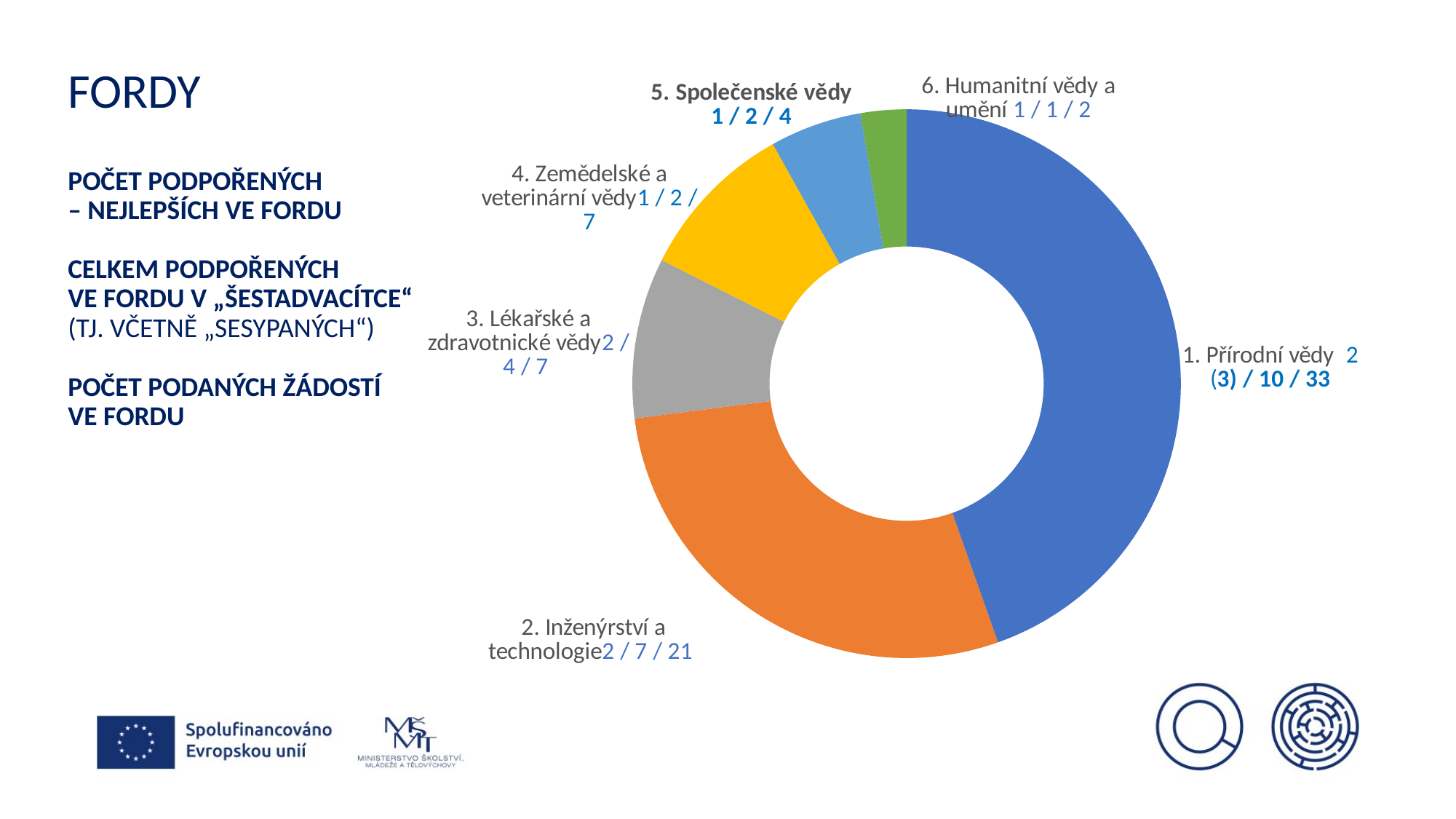
What is the title of the slide containing the chart? FORDY Which category has the smallest slice in the chart? 6. Humanitní vědy a umění What is the difference between the number of submitted applications (last number in the label) for '1. Přírodní vědy' and '2. Inženýrství a technologie'? 12 What values are printed next to the label '5. Společenské vědy'? 1 / 2 / 4 What values are printed next to the label '6. Humanitní vědy a umění'? 1 / 1 / 2 What kind of chart is shown on the slide? doughnut chart How many categories (slices) does the chart have? 6 What colour is the slice for '4. Zemědelské a veterinární vědy'? yellow Which slice is larger: '2. Inženýrství a technologie' or '3. Lékařské a zdravotnické vědy'? 2. Inženýrství a technologie Which category has the largest slice in the chart? 1. Přírodní vědy What values are printed next to the label '1. Přírodní vědy'? 2 (3) / 10 / 33 What values are printed next to the label '2. Inženýrství a technologie'? 2 / 7 / 21